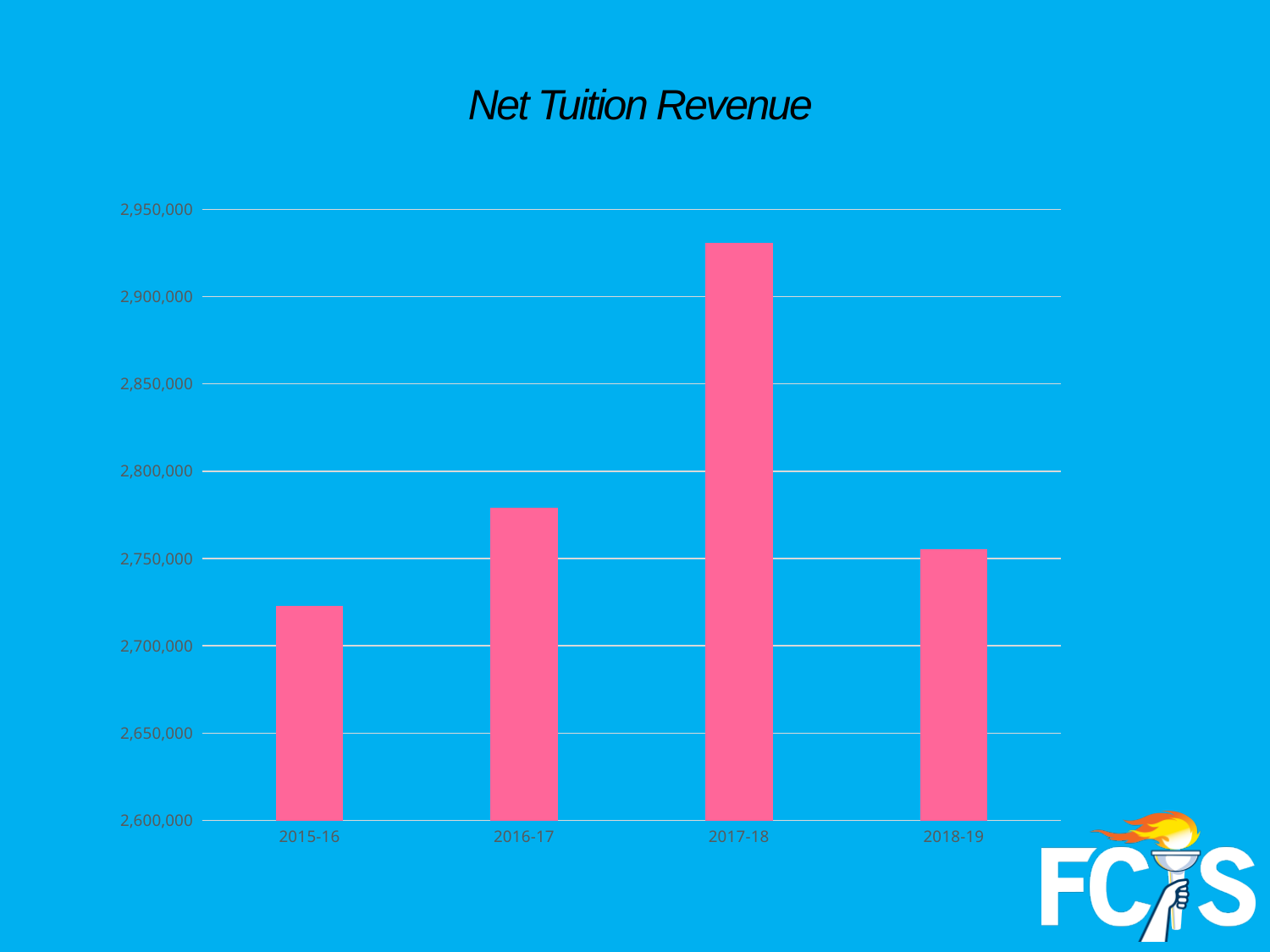
Is the value for 2017-18 greater or less than 2,900,000? greater How many academic years are shown on the x axis? 4 Is the value for 2016-17 greater or less than 2,800,000? less Does net tuition revenue rise or fall from 2017-18 to 2018-19? fall What colour are the bars in the chart? pink Which is larger, the net tuition revenue for 2016-17 or for 2018-19? 2016-17 Is the value for 2015-16 greater or less than 2,750,000? less Which year has the lowest net tuition revenue? 2015-16 What kind of chart is shown on the slide? bar chart Which is larger, the net tuition revenue for 2015-16 or for 2018-19? 2018-19 What is the title of the chart? Net Tuition Revenue Which year has the highest net tuition revenue? 2017-18